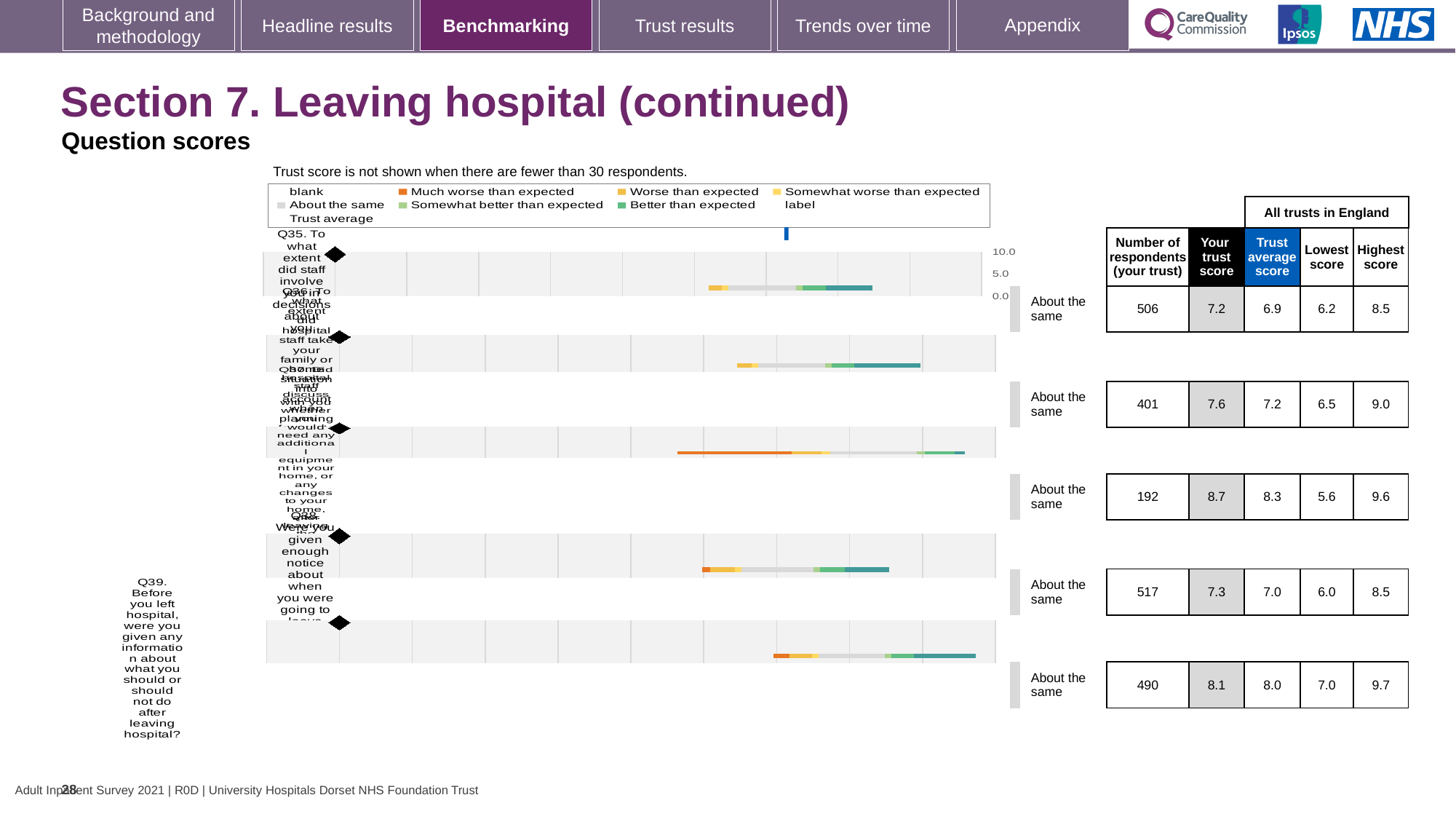
What benchmark category is shown for every question in the chart? About the same What kind of chart is shown on the slide? bar chart What is the trust average score for the first row (Q35)? 6.9 What is the maximum value shown on the score axis? 10.0 Which row has the lowest number of respondents? the third row (192) Which row has the highest 'Your trust score'? the third row (8.7) What is the number of respondents for Q39? 490 What is the trust score for Q39 (Before you left hospital, were you given any information about what you should or should not do after leaving hospital?)? 8.1 What is the difference between the trust score and the trust average score for Q39? 0.1 How many questions (rows) are plotted in the chart? 5 What is the highest score across all trusts in England for Q39? 9.7 Is the trust score for the first row (Q35) larger than its trust average score? yes, 7.2 vs 6.9